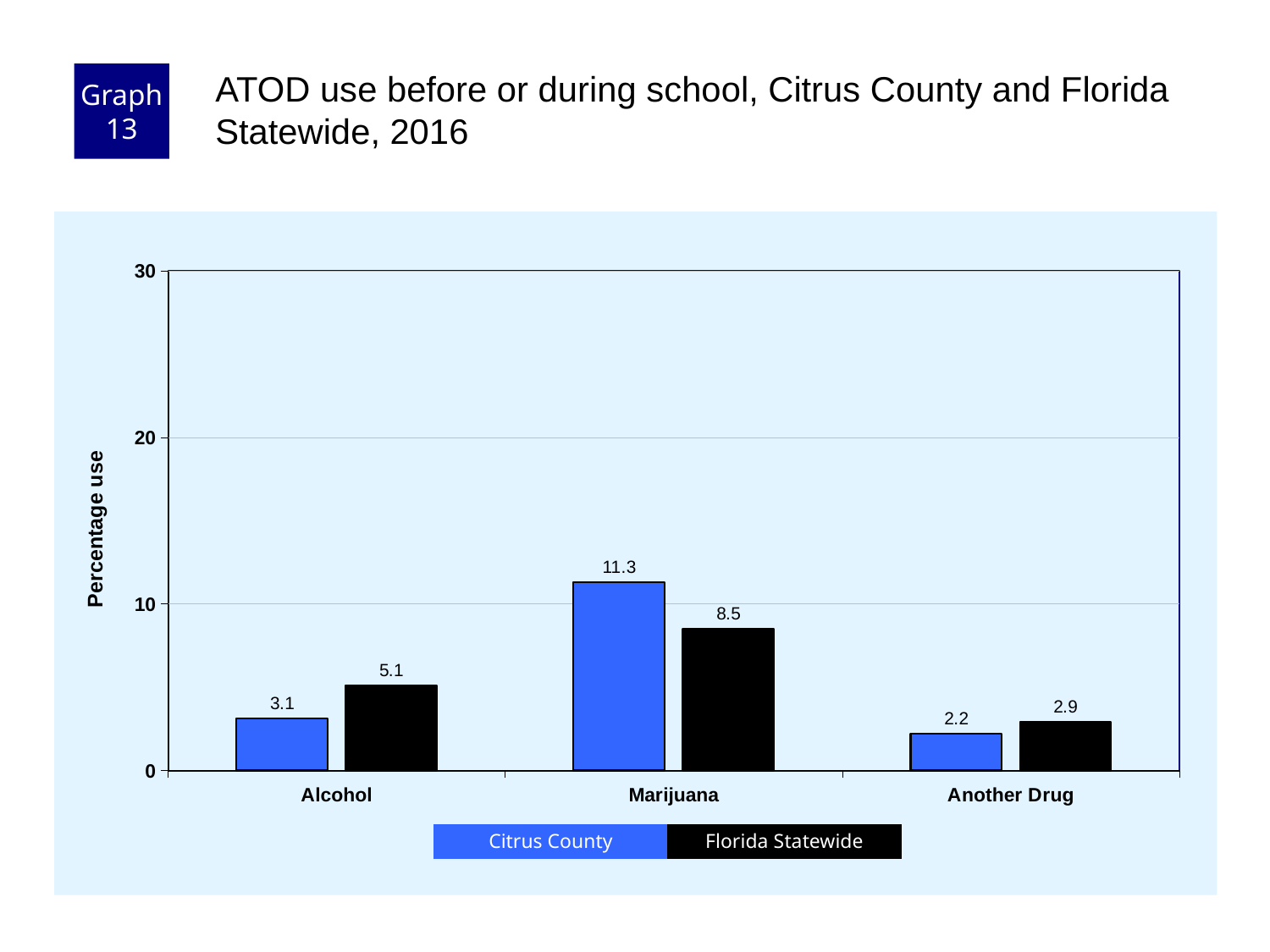
Is the Citrus County value for Marijuana greater or less than 10? greater How many series does the legend list? 2 What is the difference between the Citrus County and Florida Statewide values for Marijuana? 2.8 What is the Citrus County value for Another Drug? 2.2 How many categories are shown on the x axis? 3 Which category has the highest Citrus County value? Marijuana What is the Citrus County value for Marijuana? 11.3 Which is larger for Alcohol, the Citrus County value or the Florida Statewide value? Florida Statewide What kind of chart is shown on the slide? bar chart Which category has the lowest Florida Statewide value? Another Drug What is the Florida Statewide value for Alcohol? 5.1 What is the difference between the Florida Statewide and Citrus County values for Alcohol? 2.0